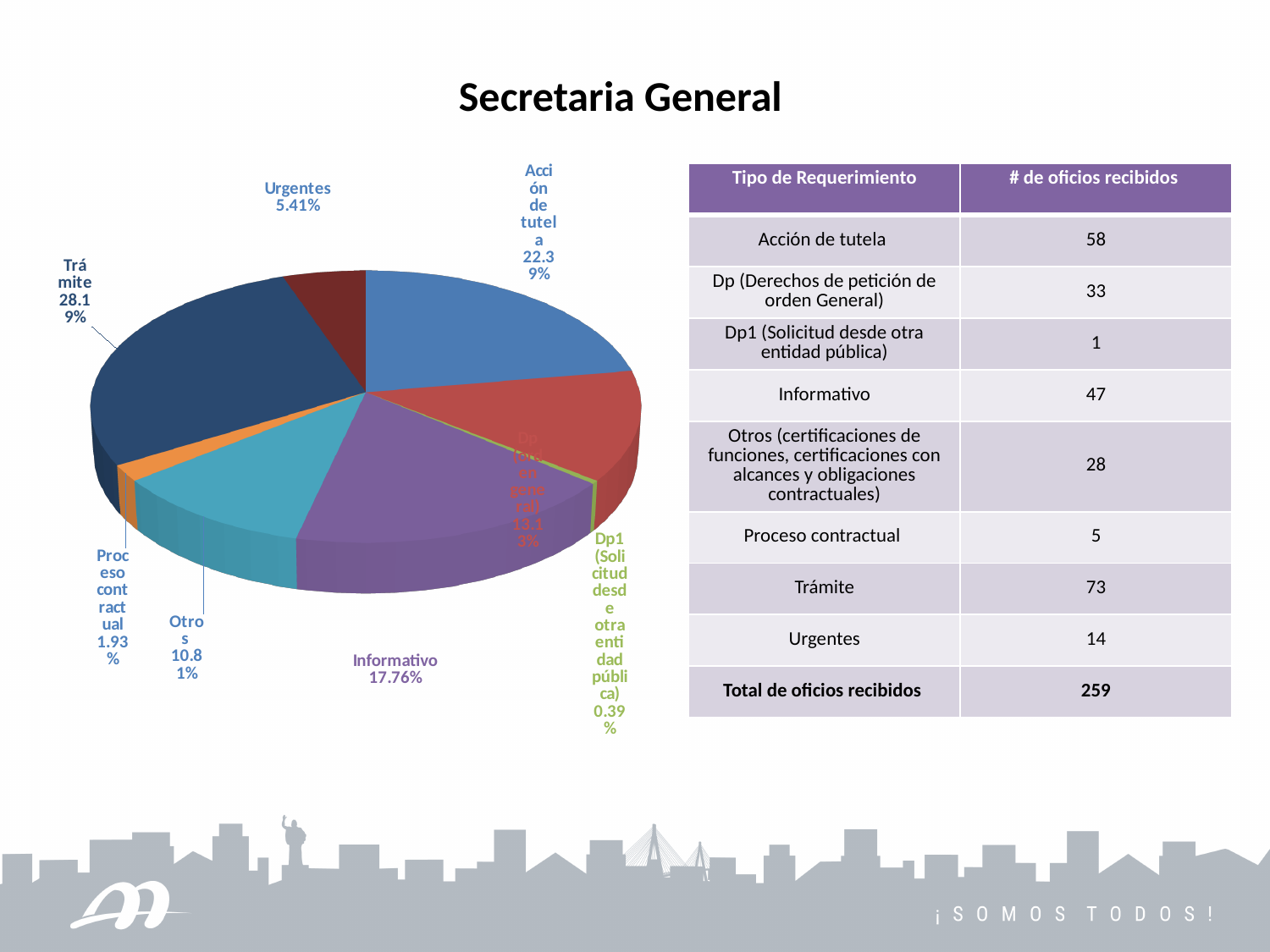
What percentage does the pie chart show for Proceso contractual? 1.93% What percentage does the pie chart show for Urgentes? 5.41% What percentage does the pie chart show for Acción de tutela? 22.39% What is the title of the slide containing the pie chart? Secretaria General How many slices does the pie chart have? 8 What kind of chart is shown on the slide? Pie chart Which category has the largest slice in the pie chart? Trámite What percentage does the pie chart show for Informativo? 17.76% What percentage does the pie chart show for Trámite? 28.19% What is the difference in percentage points between the Trámite slice and the Acción de tutela slice? 5.80% Which slice is larger in the pie chart, Acción de tutela or Informativo? Acción de tutela Which category has the smallest slice in the pie chart? Dp1 (Solicitud desde otra entidad pública)